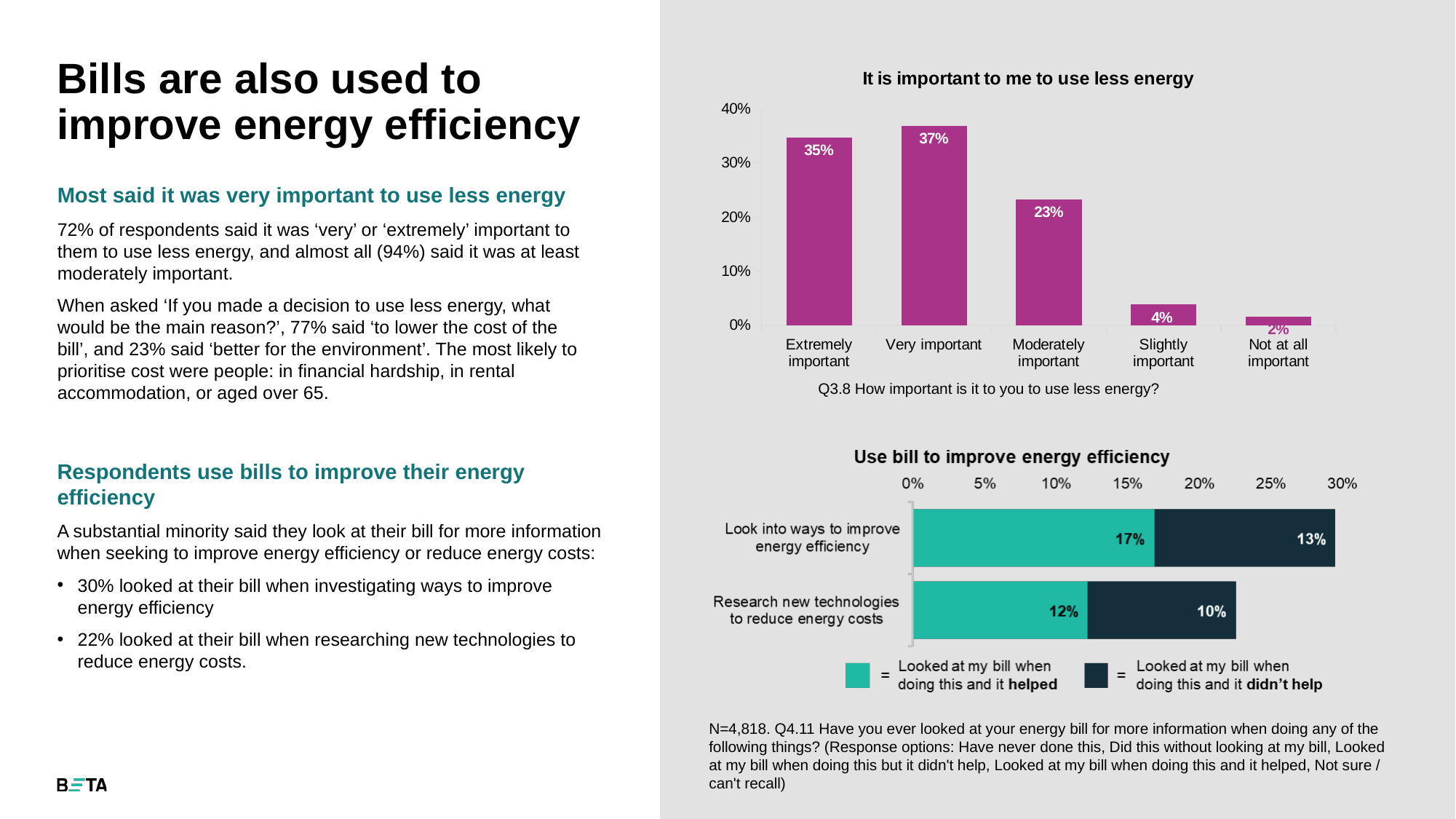
In the chart titled 'Use bill to improve energy efficiency', what is the total of the stacked bar for 'Research new technologies to reduce energy costs'? 22% In the chart titled 'It is important to me to use less energy', what is the value for 'Very important'? 37% What kind of chart is the chart titled 'Use bill to improve energy efficiency'? stacked bar chart In the chart titled 'Use bill to improve energy efficiency', which is larger: the 'didn't help' segment for 'Look into ways to improve energy efficiency' or the 'didn't help' segment for 'Research new technologies to reduce energy costs'? Look into ways to improve energy efficiency In the chart titled 'It is important to me to use less energy', what is the difference between 'Extremely important' and 'Slightly important'? 31% In the chart titled 'It is important to me to use less energy', which category has the highest value? Very important In the chart titled 'Use bill to improve energy efficiency', what is the value of the 'helped' segment for 'Look into ways to improve energy efficiency'? 17% In the chart titled 'It is important to me to use less energy', what is the value for 'Moderately important'? 23% In the chart titled 'It is important to me to use less energy', which category has the lowest value? Not at all important In the chart titled 'It is important to me to use less energy', do the values rise or fall from 'Very important' to 'Not at all important'? fall In the chart titled 'It is important to me to use less energy', how many categories are shown on the x axis? 5 In the chart titled 'Use bill to improve energy efficiency', how many series does the legend list? 2